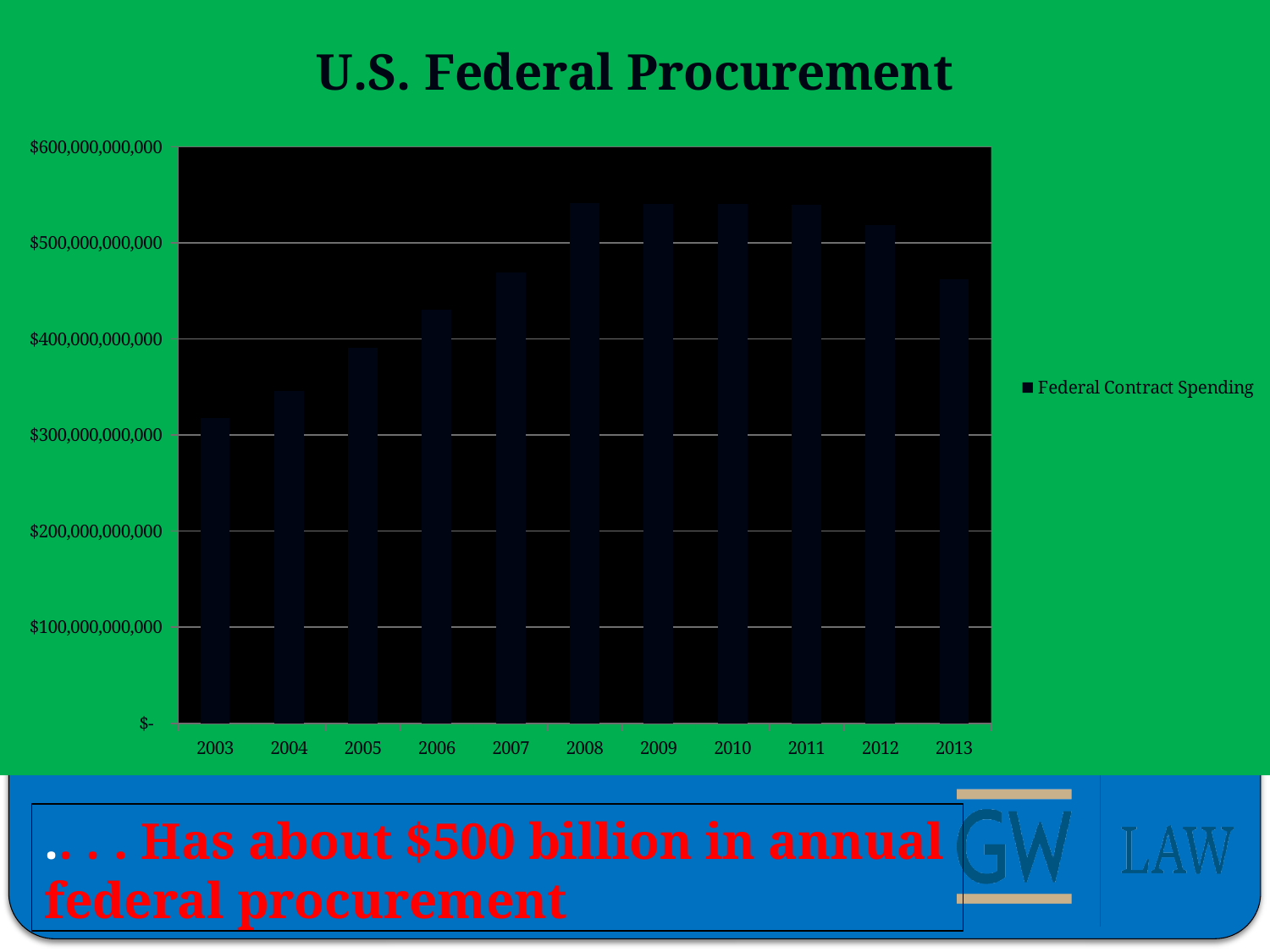
How many series does the legend list? 1 Which year has the larger Federal Contract Spending, 2012 or 2013? 2012 Is the value for 2013 greater or less than $500,000,000,000? less What kind of chart is shown on the slide? bar chart How many years are shown on the x axis? 11 What is the name of the series shown in the legend? Federal Contract Spending Is the value for 2003 greater or less than $300,000,000,000? greater Is the value for 2005 greater or less than $400,000,000,000? less Do the values rise or fall from 2003 to 2008? rise What is the title of the chart? U.S. Federal Procurement Which year has the lowest Federal Contract Spending? 2003